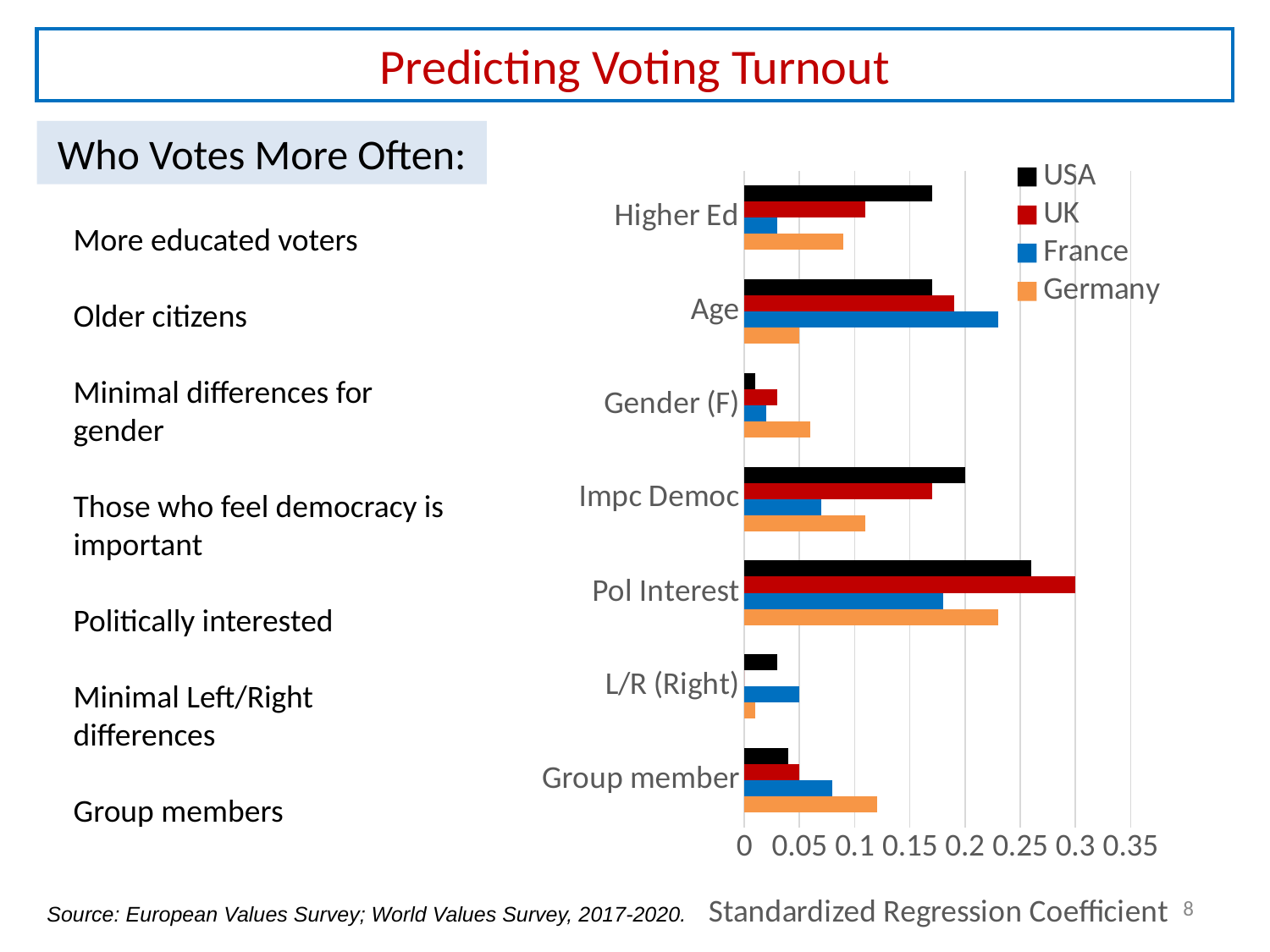
Is the value for USA in Pol Interest greater or less than 0.2? greater Which country has the highest value for Age? France How many categories are plotted on the y axis of the chart? 7 Which country has the lowest value for Higher Ed? France What is the label of the x axis of the chart? Standardized Regression Coefficient Is the value for France in Age greater or less than 0.2? greater For Higher Ed, which is larger: the value for USA or the value for France? USA How many series does the legend list? 4 Which category has the highest value for UK? Pol Interest What kind of chart is shown on the slide? bar chart For Group member, which is larger: the value for Germany or the value for USA? Germany Is the value for Germany in Gender (F) greater or less than 0.1? less